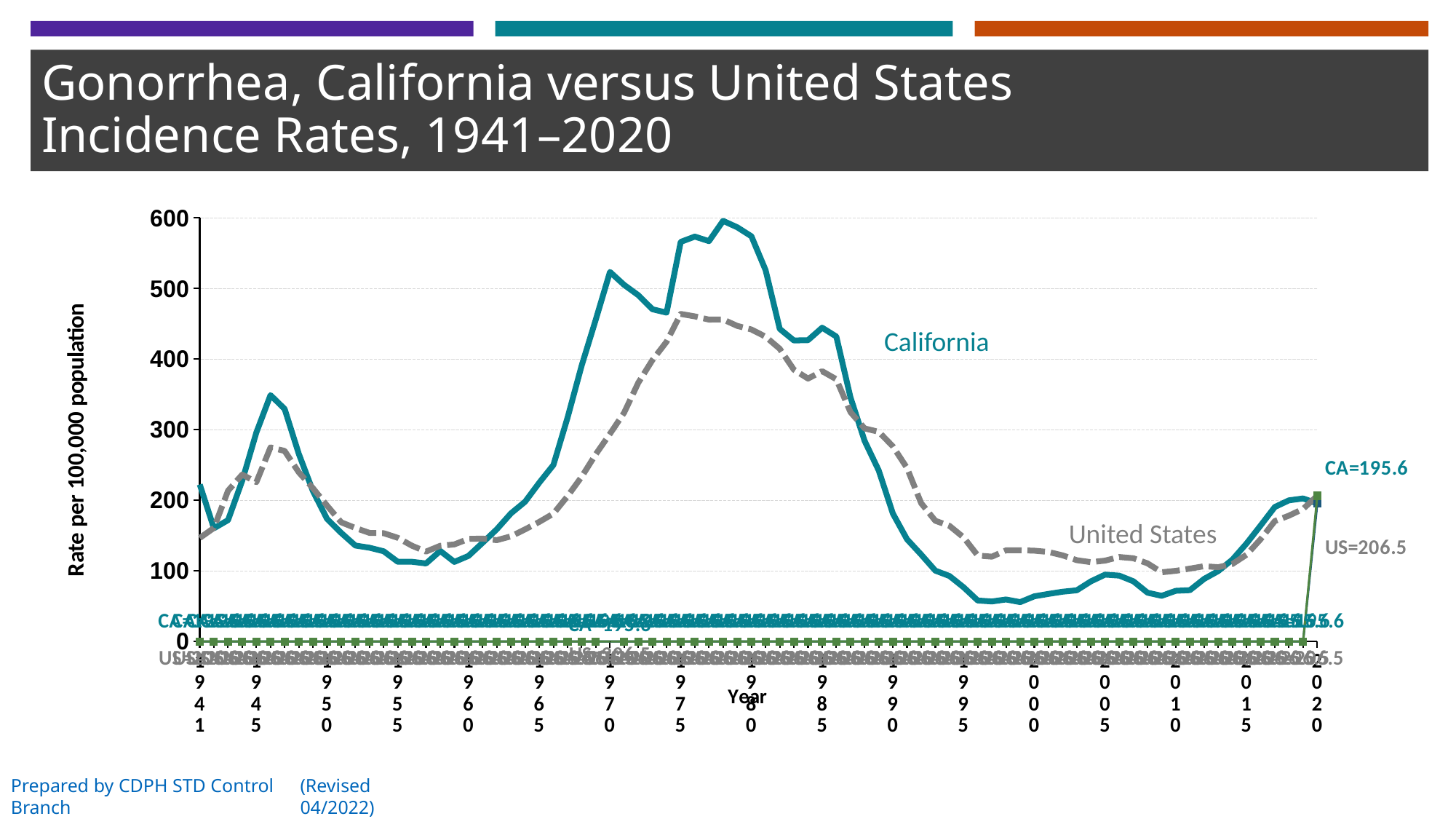
Is the California rate in 1995 greater or less than 100? less What is the label on the vertical axis of the chart? Rate per 100,000 population Does the California rate rise or fall between 2010 and 2020? rise What is the United States gonorrhea incidence rate in 2020, as labeled on the chart? US=206.5 Is the United States rate in 1975 greater or less than 500? less What is the California gonorrhea incidence rate in 2020, as labeled on the chart? CA=195.6 How many series are plotted on the chart? 4 Which series reaches the highest peak on the chart? California In 2020, which has the higher incidence rate, California or the United States? United States What kind of chart is shown on the slide? line chart Is the California rate in 1975 greater or less than 500? greater What is the difference between the United States rate and the California rate in 2020? 10.9